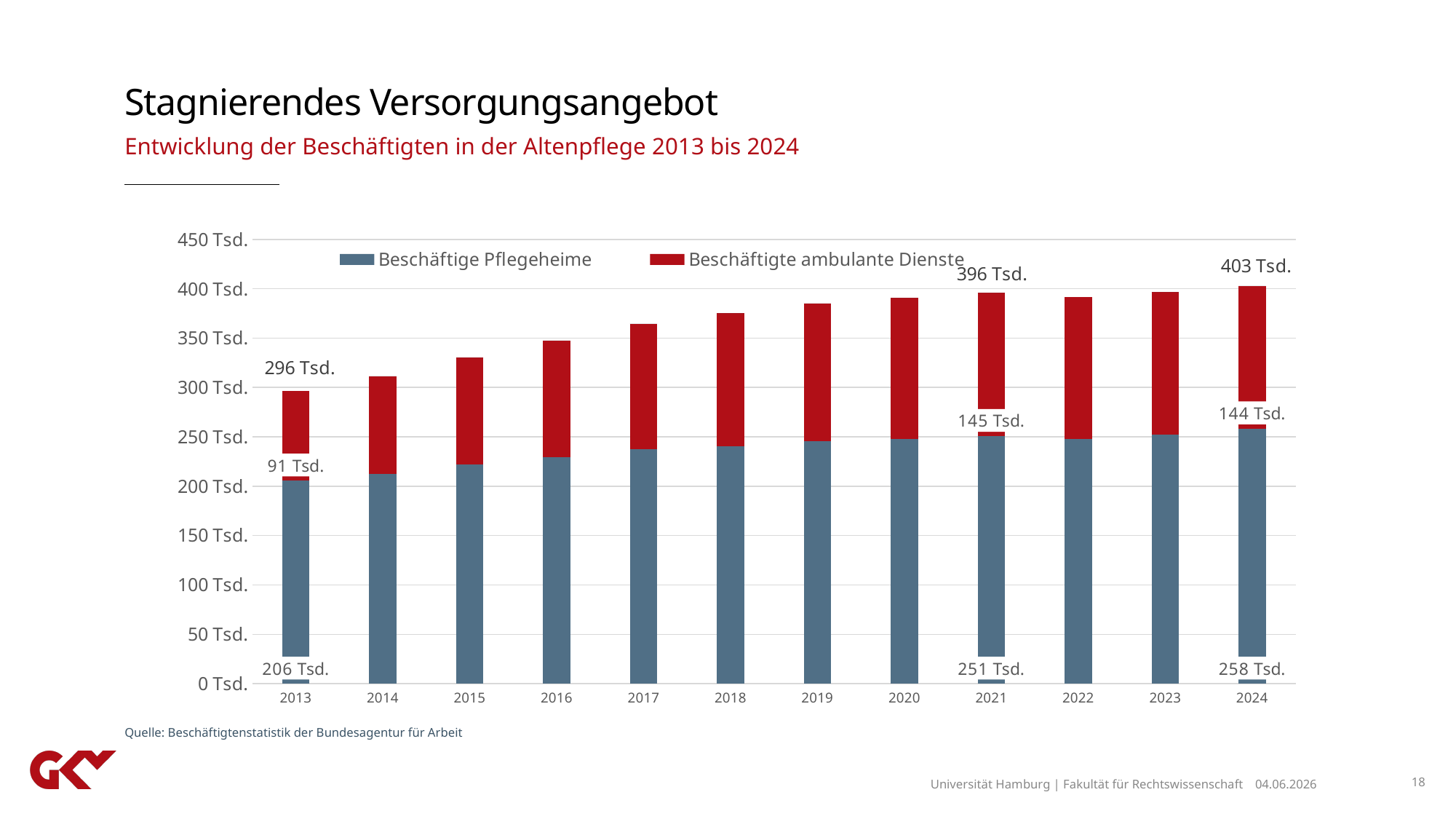
How many years are shown on the x axis? 12 What is the value for Beschäftige Pflegeheime in 2013? 206 Tsd. Which year has the lowest total number of employees? 2013 What is the total of the stacked bar for 2024? 403 Tsd. How many series does the legend list? 2 Which series is shown in red in the legend? Beschäftigte ambulante Dienste Which year has the highest total number of employees? 2024 What kind of chart is shown on the slide? Stacked bar chart Is the total value for 2018 greater or less than 350 Tsd.? greater What is the total of the stacked bar for 2013? 296 Tsd. What is the value for Beschäftigte ambulante Dienste in 2021? 145 Tsd. What is the difference between the Beschäftige Pflegeheime values for 2024 and 2013? 52 Tsd.